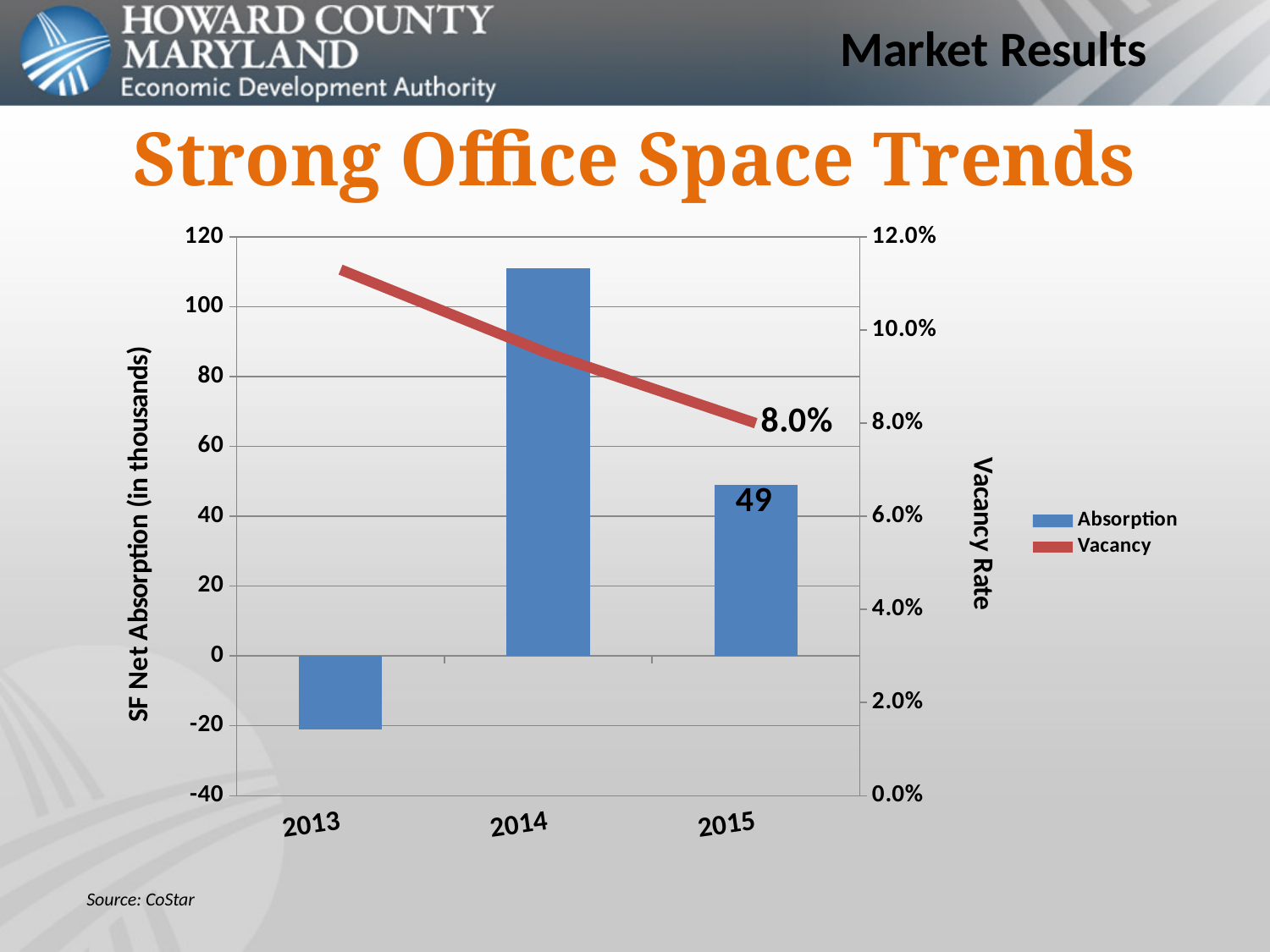
What is the Vacancy rate for 2015? 8.0% Is the Absorption value for 2014 greater or less than 100? greater What is the Absorption value for 2015? 49 What is the title of the right-hand vertical axis? Vacancy Rate Is the Vacancy rate for 2013 greater or less than 10.0%? greater What kind of chart is used to show the Absorption series? bar chart Does the Vacancy rate rise or fall from 2013 to 2015? fall Which year has the lowest Absorption? 2013 Is the Absorption value for 2013 greater or less than 0? less How many years are shown on the x axis? 3 Which year has the highest Absorption? 2014 How many series does the legend list? 2